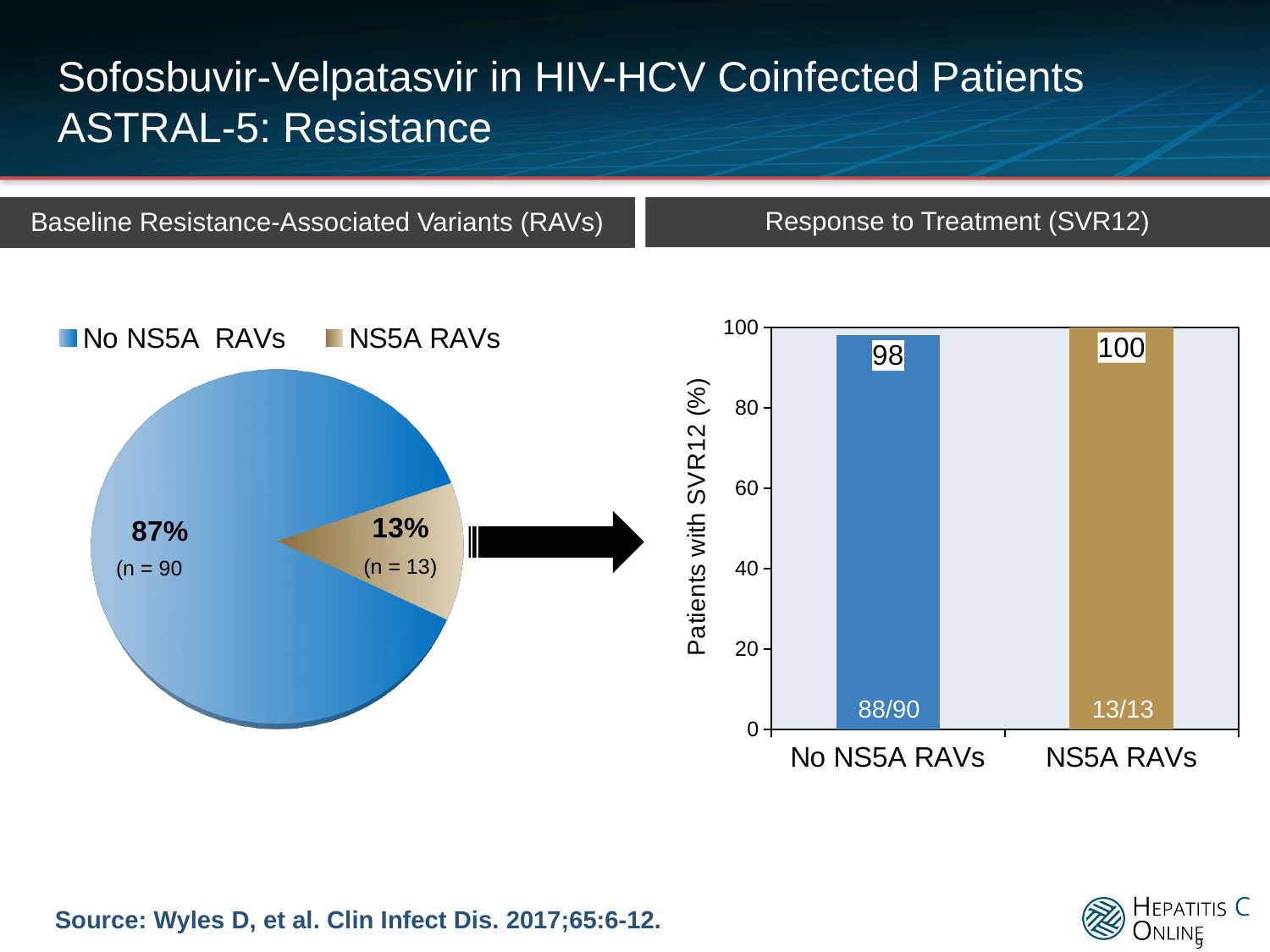
In the Response to Treatment (SVR12) chart, what is the y-axis label? Patients with SVR12 (%) What kind of chart is shown under Response to Treatment (SVR12)? Bar chart In the Response to Treatment (SVR12) chart, what fraction is printed on the No NS5A RAVs bar? 88/90 In the Baseline Resistance-Associated Variants (RAVs) pie chart, what percentage of patients had NS5A RAVs? 13% In the Response to Treatment (SVR12) chart, what is the SVR12 rate for patients with No NS5A RAVs? 98 In the Response to Treatment (SVR12) chart, what is the difference in SVR12 rate between NS5A RAVs and No NS5A RAVs? 2 What kind of chart is shown under Baseline Resistance-Associated Variants (RAVs)? Pie chart In the Baseline Resistance-Associated Variants (RAVs) pie chart, how many patients had NS5A RAVs? n = 13 In the Baseline Resistance-Associated Variants (RAVs) pie chart, how many slices are there? 2 In the Baseline Resistance-Associated Variants (RAVs) pie chart, what percentage of patients had no NS5A RAVs? 87% In the Response to Treatment (SVR12) chart, what is the SVR12 rate for patients with NS5A RAVs? 100 In the Baseline Resistance-Associated Variants (RAVs) pie chart, which slice is larger, No NS5A RAVs or NS5A RAVs? No NS5A RAVs